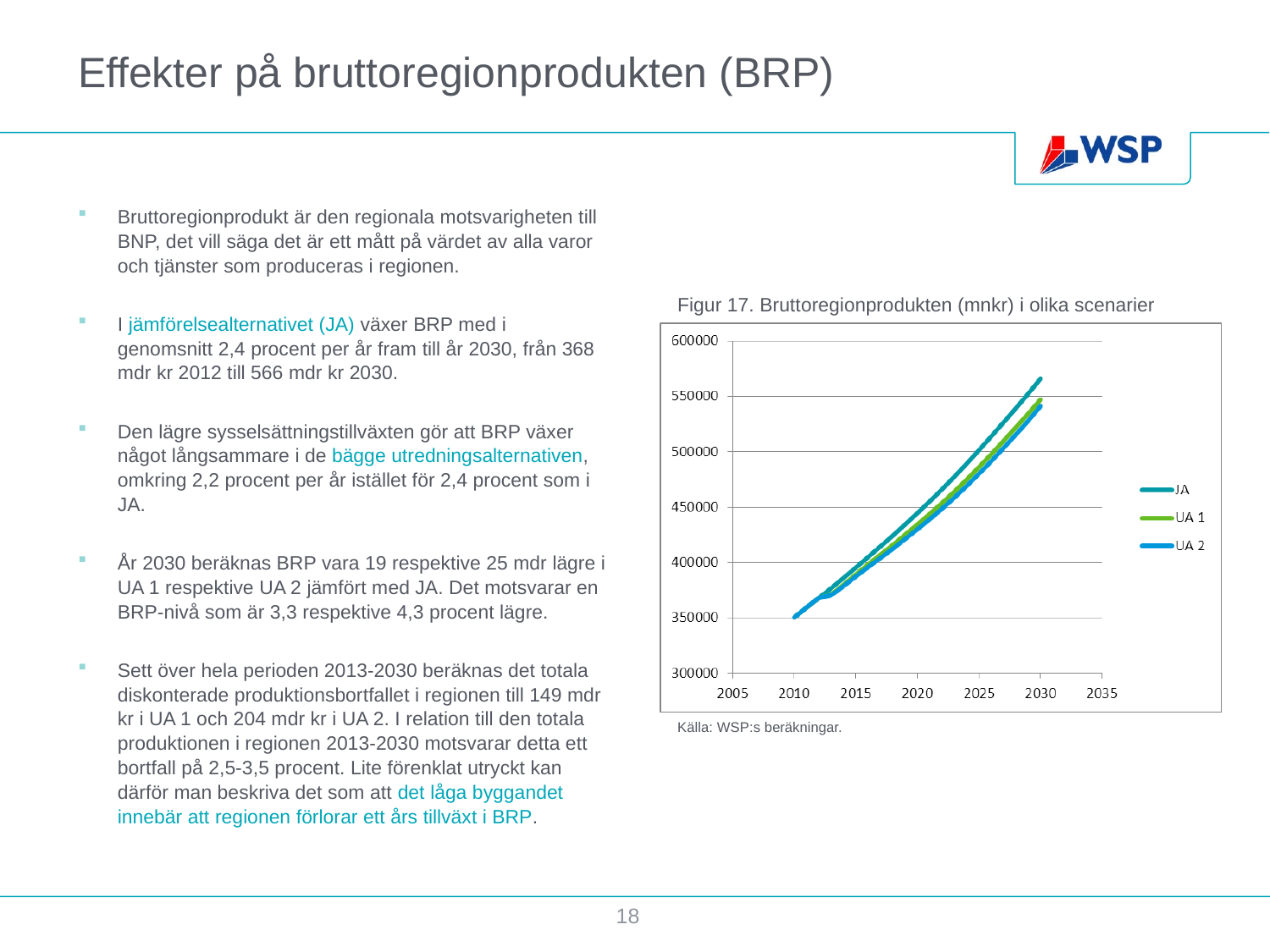
Is the value for JA in 2030 greater or less than 550000? greater Which series has the highest value in 2030? JA Do the values of the JA series rise or fall from 2010 to 2030? Rise Which series are listed in the chart's legend? JA, UA 1, UA 2 How many series does the legend of the chart list? 3 Is the value for UA 2 in 2030 greater or less than 600000? less What is the title of the chart? Figur 17. Bruttoregionprodukten (mnkr) i olika scenarier Is the value for UA 1 in 2020 greater or less than 500000? less What kind of chart is shown on the slide? Line chart In 2030, which is larger: the value for JA or the value for UA 2? JA Do the values of the UA 2 series rise or fall along the x axis? Rise